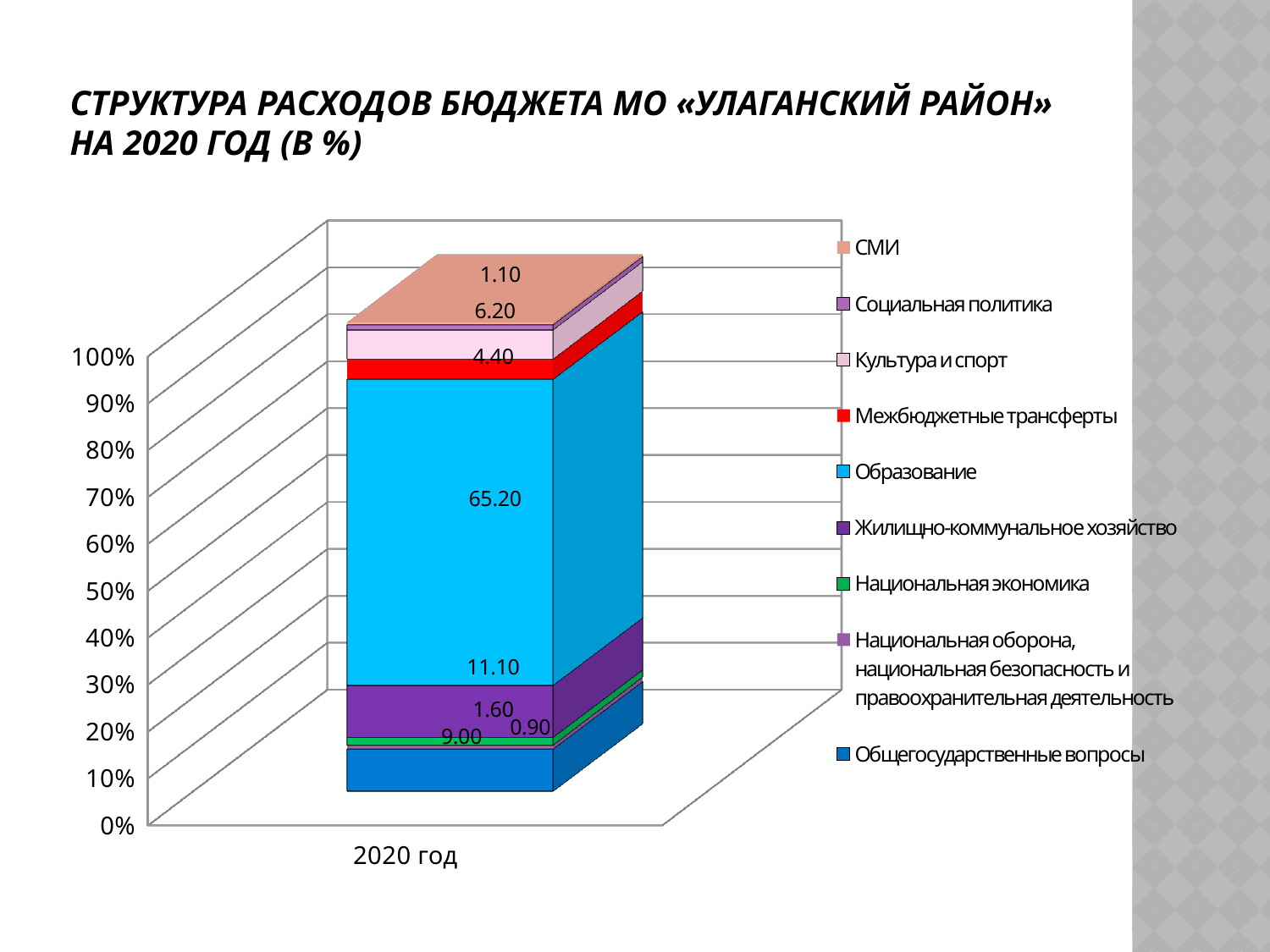
What is the value for Общегосударственные вопросы? 9.00 What is the difference between the values for Образование and Жилищно-коммунальное хозяйство? 54.10 What is the value for Образование? 65.20 What is the value for Культура и спорт? 6.20 Which series has the largest share of the bar? Образование What is the value for Жилищно-коммунальное хозяйство? 11.10 What kind of chart is shown on the slide? stacked bar chart How many series does the legend list? 9 What is the category label on the x axis? 2020 год Which is larger, the value for Образование or the value for Жилищно-коммунальное хозяйство? Образование How many categories are shown on the x axis? 1